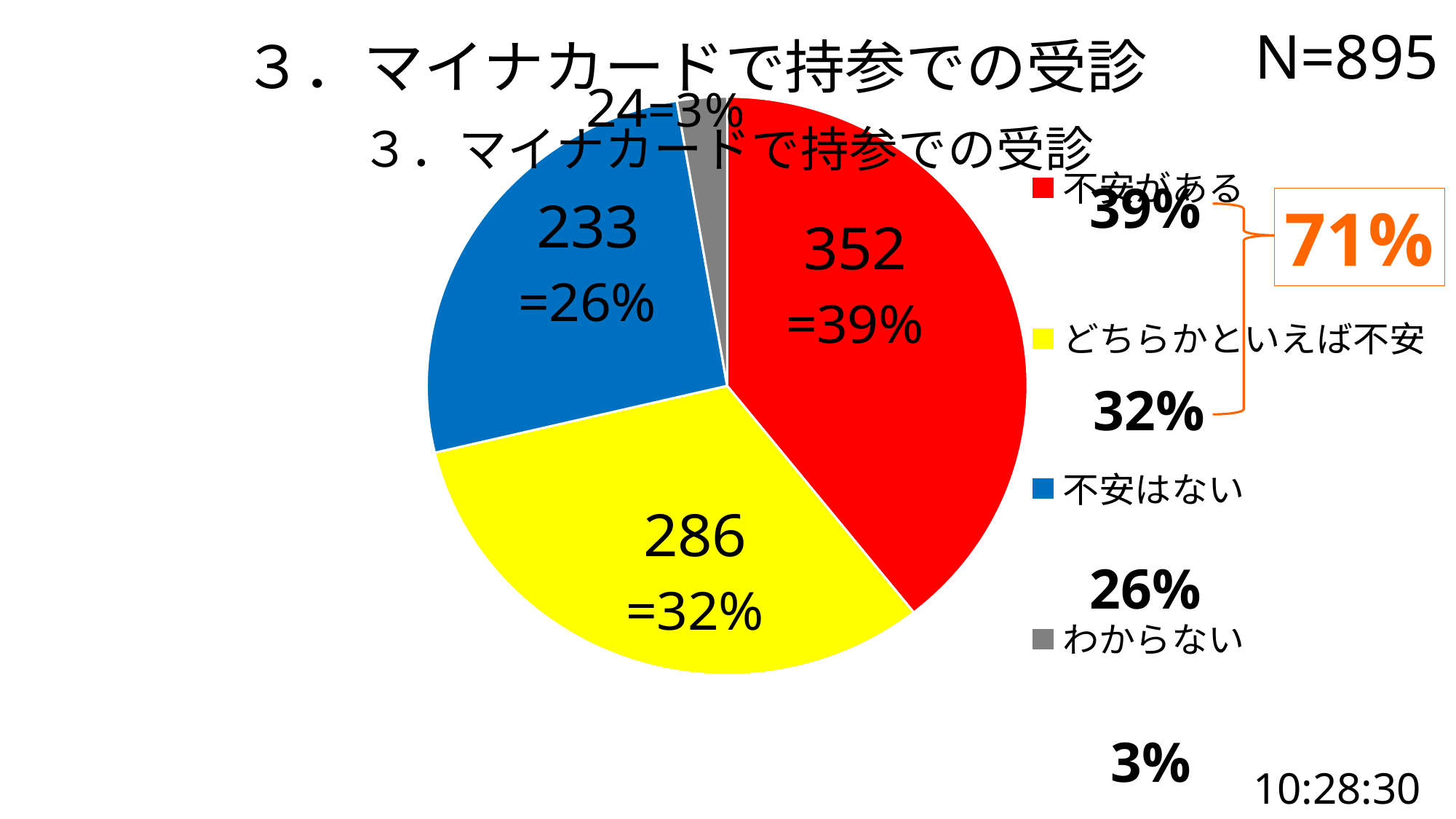
What share of the pie does わからない represent? 3% What is the value for 不安がある? 352 What is the value for 不安はない? 233 How many slices does the pie chart have? 4 What share of the pie does 不安はない represent? 26% What kind of chart is shown on the slide? pie chart What is the difference between the values for 不安がある and どちらかといえば不安? 66 Which category has the largest slice? 不安がある What is the value for わからない? 24 What is the value for どちらかといえば不安? 286 Which category has the smallest slice? わからない Which is larger, the value for どちらかといえば不安 or the value for 不安はない? どちらかといえば不安